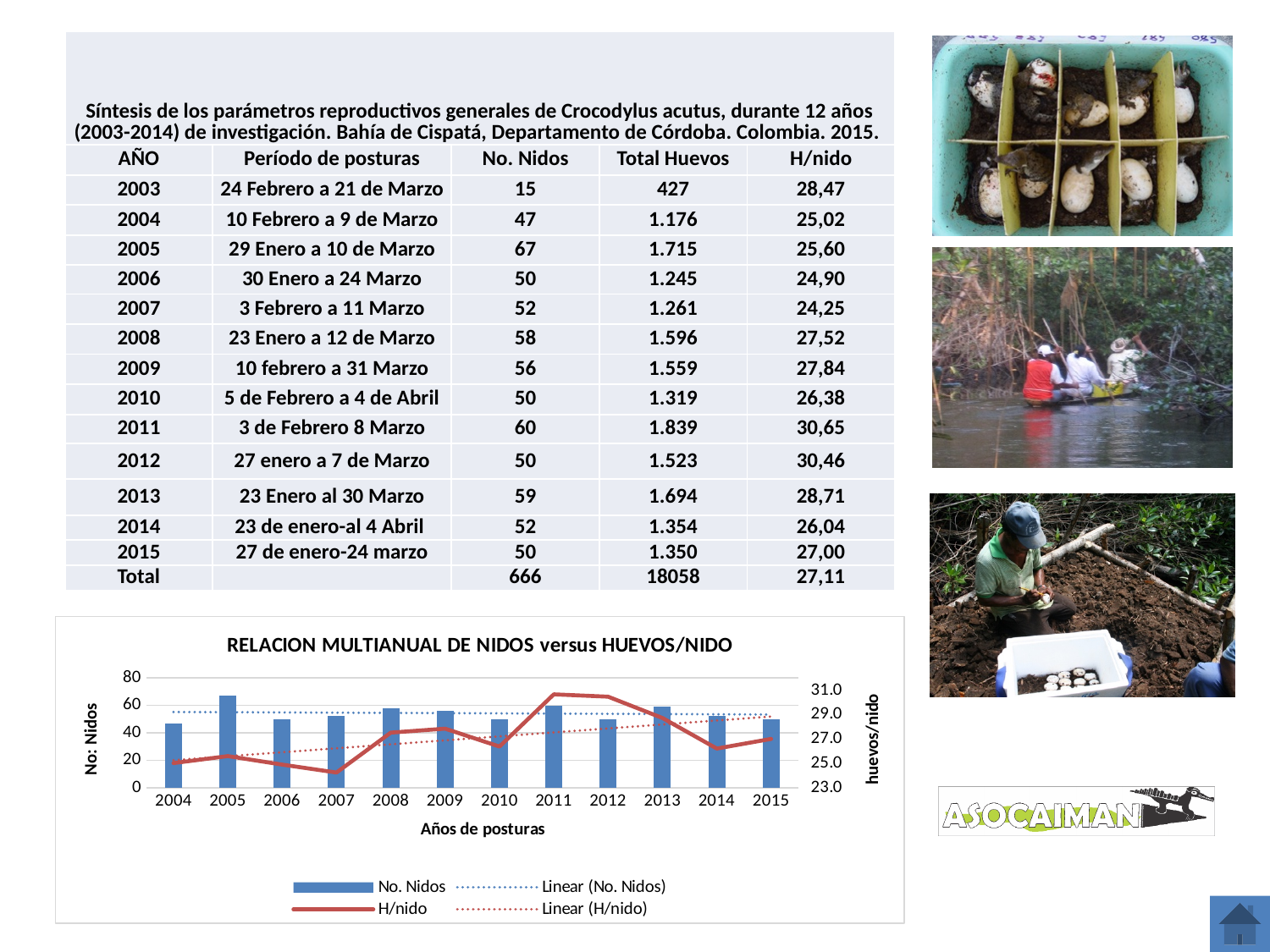
Does the H/nido line rise or fall from 2011 to 2014? fall Which year has the larger No. Nidos bar, 2010 or 2011? 2011 In which year is the No. Nidos bar the highest? 2005 What is the label of the right-hand vertical axis of the chart? huevos/nido How many years are shown along the x axis of the chart? 12 What kind of chart is shown on the slide? Combined bar and line chart Is the No. Nidos value for 2007 greater or less than 60? less In which year does the H/nido line reach its lowest point? 2007 In which year is the No. Nidos bar the lowest? 2004 What is the title of the chart on the slide? RELACION MULTIANUAL DE NIDOS versus HUEVOS/NIDO How many entries does the chart legend list? 4 Is the No. Nidos value for 2005 greater or less than 60? greater